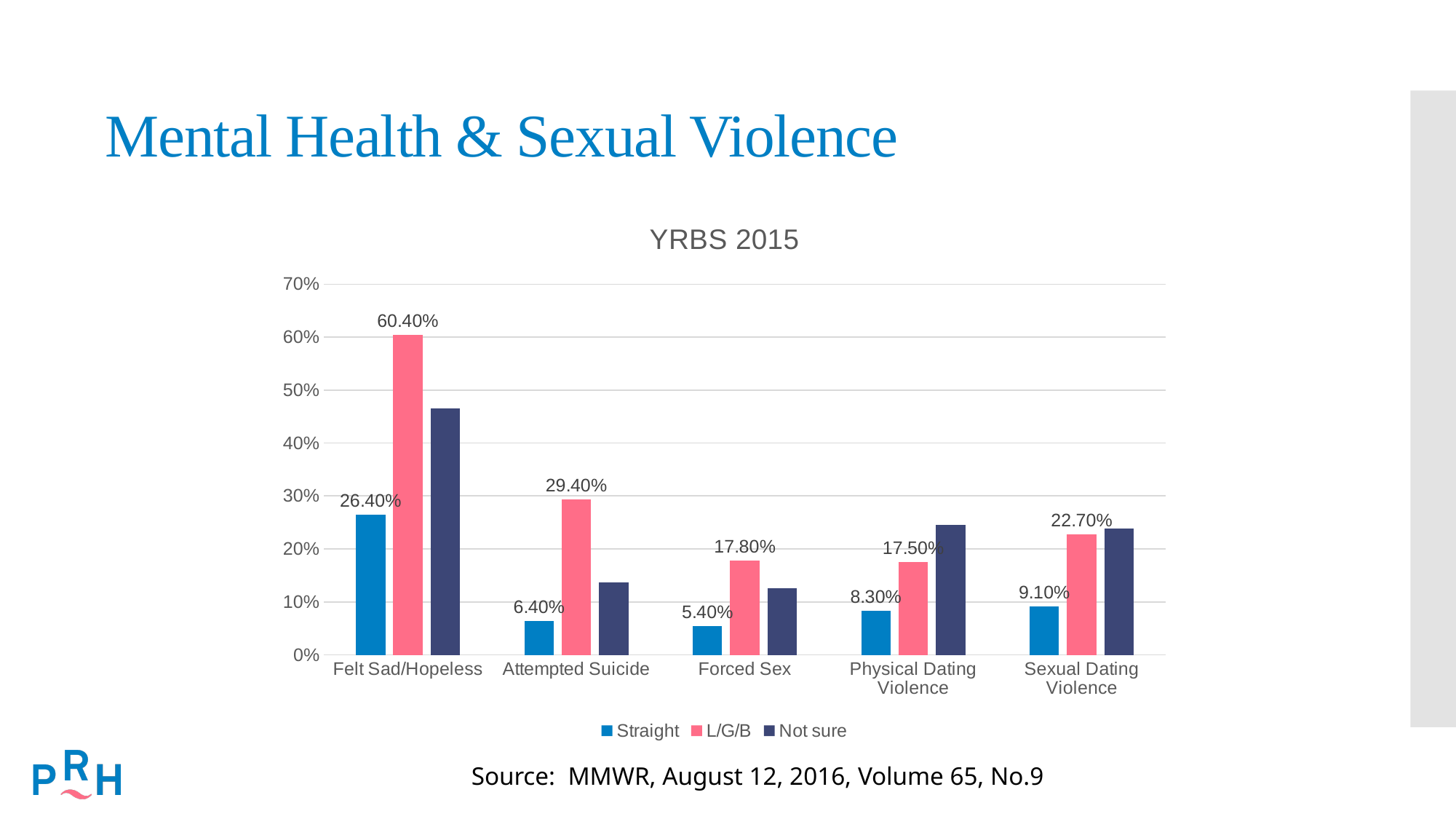
What is the Straight value for Attempted Suicide? 6.40% What is the L/G/B value for Sexual Dating Violence? 22.70% Which category has the highest Straight value? Felt Sad/Hopeless Which category has the lowest Straight value? Forced Sex What is the difference between the L/G/B and Straight values for Felt Sad/Hopeless? 34.00% How many series does the legend list? 3 Is the Not sure value for Felt Sad/Hopeless greater or less than 40%? greater Which is larger for Physical Dating Violence: the Straight value or the L/G/B value? L/G/B Is the Not sure value for Forced Sex greater or less than 20%? less What is the L/G/B value for Felt Sad/Hopeless? 60.40% How many categories are shown on the x axis? 5 What kind of chart is shown on the slide? Bar chart